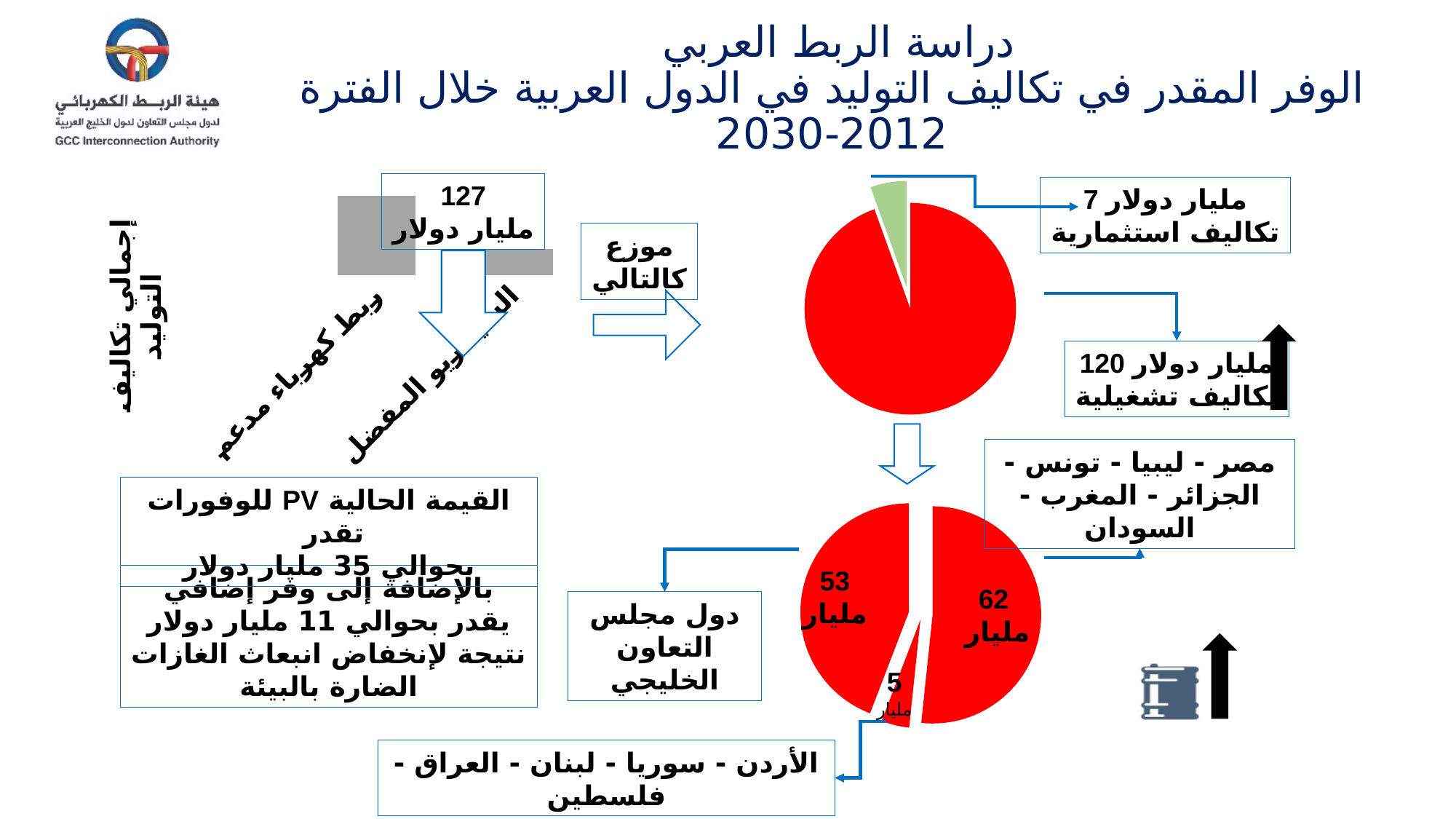
What type of chart is the lower chart on the right side of the slide? pie chart In the lower pie chart, what is the value for دول مجلس التعاون الخليجي (GCC countries)? 53 مليار In the lower pie chart, what is the value for the slice labelled الأردن - سوريا - لبنان - العراق - فلسطين? 5 مليار In the upper pie chart, which slice is the largest? تكاليف تشغيلية In the lower pie chart, what is the difference between the 62 مليار slice and the 53 مليار slice? 9 مليار In the lower pie chart, which slice is the smallest? الأردن - سوريا - لبنان - العراق - فلسطين (5 مليار) In the upper pie chart, what is the value for تكاليف تشغيلية (operating costs)? 120 مليار دولار What type of chart is the upper chart on the right side of the slide? pie chart In the lower pie chart, which slice is the largest? مصر - ليبيا - تونس - الجزائر - المغرب - السودان (62 مليار) In the upper pie chart, what is the difference between the operating costs and the investment costs? 113 مليار دولار In the upper pie chart, how many slices are there? 2 In the upper pie chart, what is the value for تكاليف استثمارية (investment costs)? 7 مليار دولار